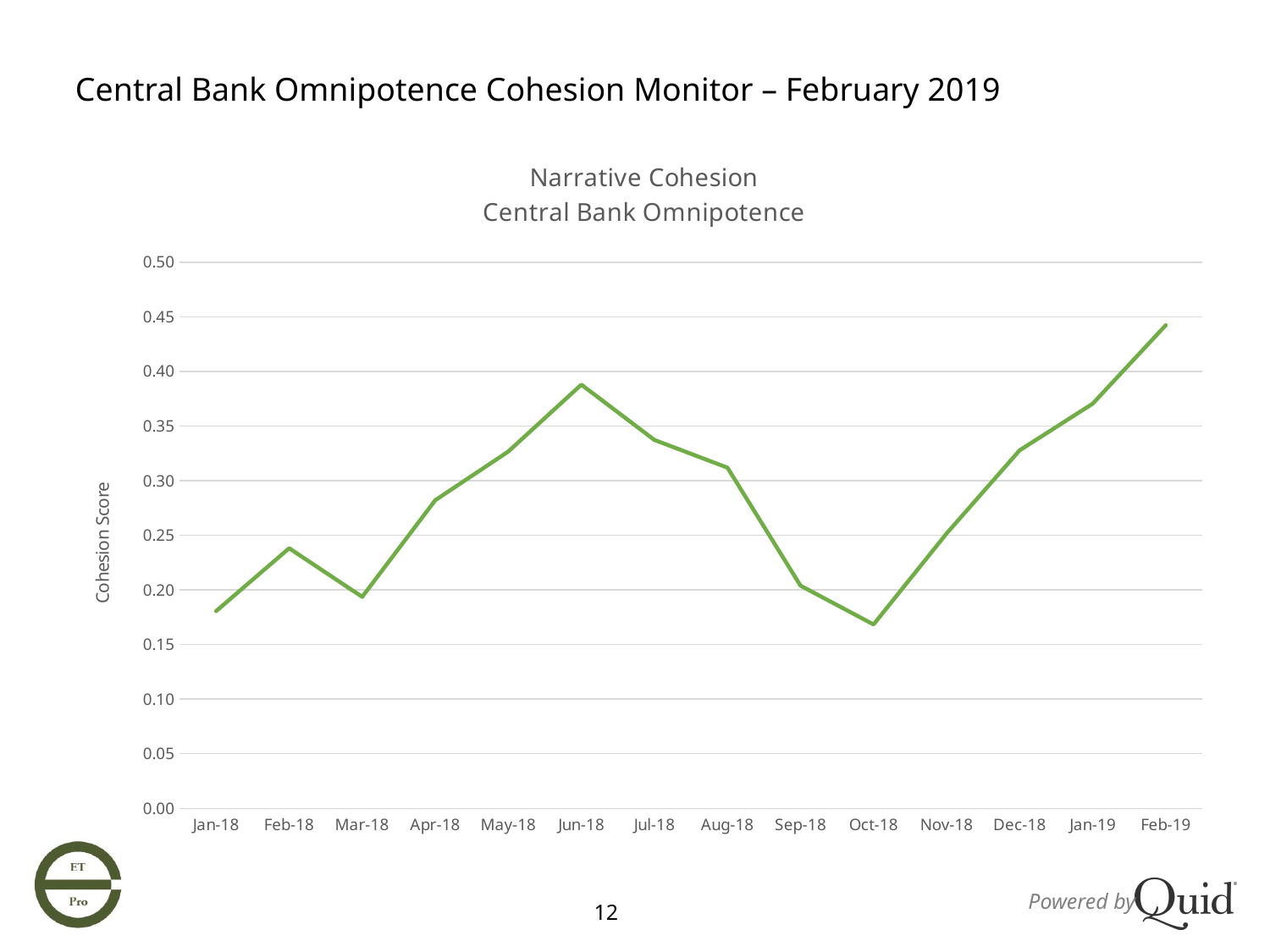
Is the cohesion score for Jun-18 greater or less than 0.35? greater Which has the higher cohesion score, Jun-18 or Jul-18? Jun-18 Which has the higher cohesion score, Feb-18 or Mar-18? Feb-18 Is the cohesion score for Oct-18 greater or less than 0.20? less Which month has the highest cohesion score? Feb-19 Is the cohesion score for Dec-18 greater or less than 0.30? greater Does the cohesion score rise or fall from Oct-18 to Feb-19? rise What is the label on the vertical axis of the chart? Cohesion Score What kind of chart is shown on the slide? line chart How many monthly data points are plotted on the chart? 14